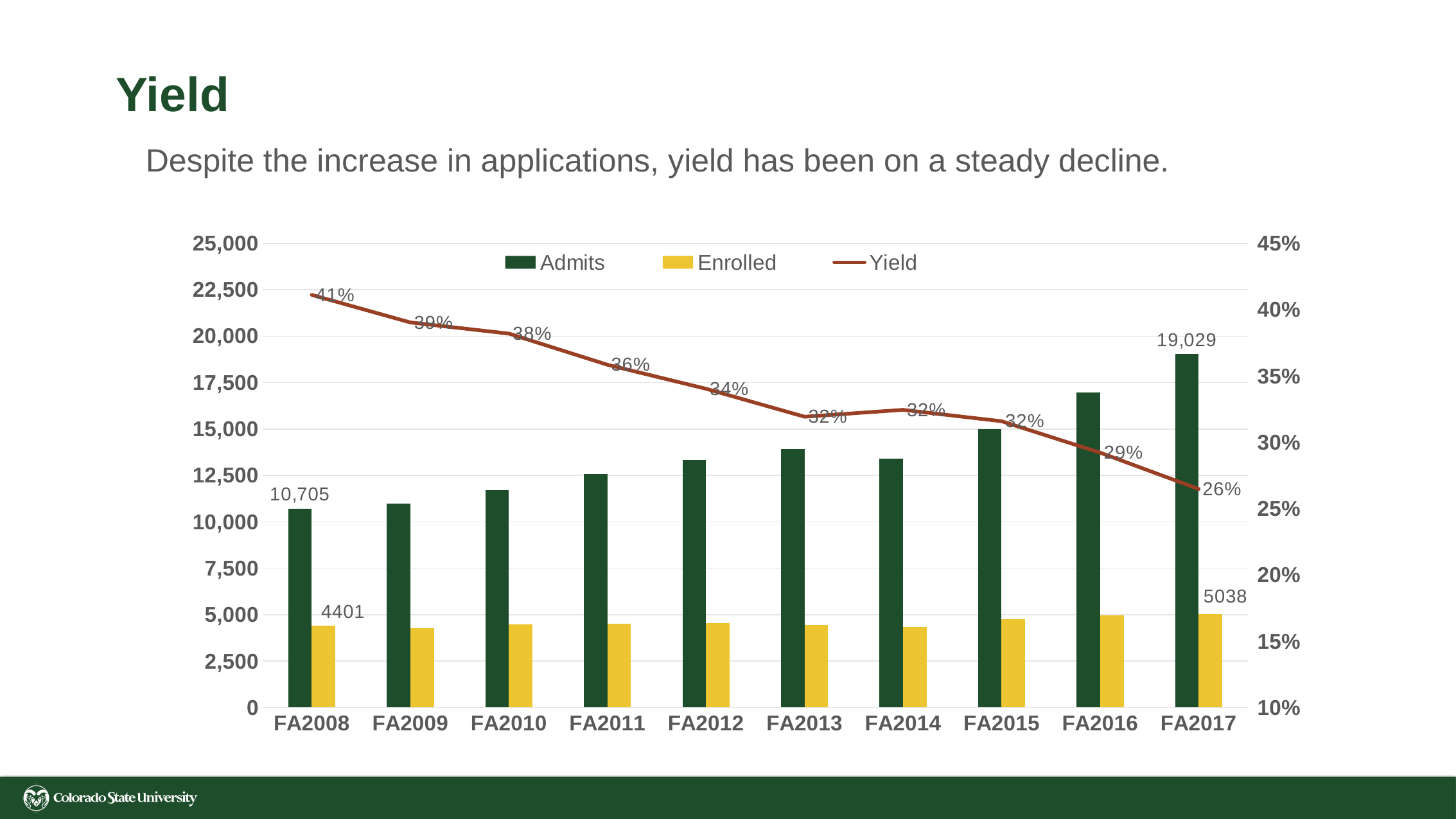
Which year has the highest Admits value? FA2017 Which year has the lowest Yield value? FA2017 What is the Admits value for FA2008? 10,705 What is the Admits value for FA2017? 19,029 Does the Yield line generally rise or fall from FA2008 to FA2017? fall What is the difference between the Admits values for FA2017 and FA2008? 8,324 Is the Admits value for FA2013 greater or less than 12,500? greater How many series does the legend list? 3 What is the Enrolled value for FA2017? 5038 What is the Yield value for FA2008? 41% How many years are shown on the x axis? 10 What is the Yield value for FA2016? 29%